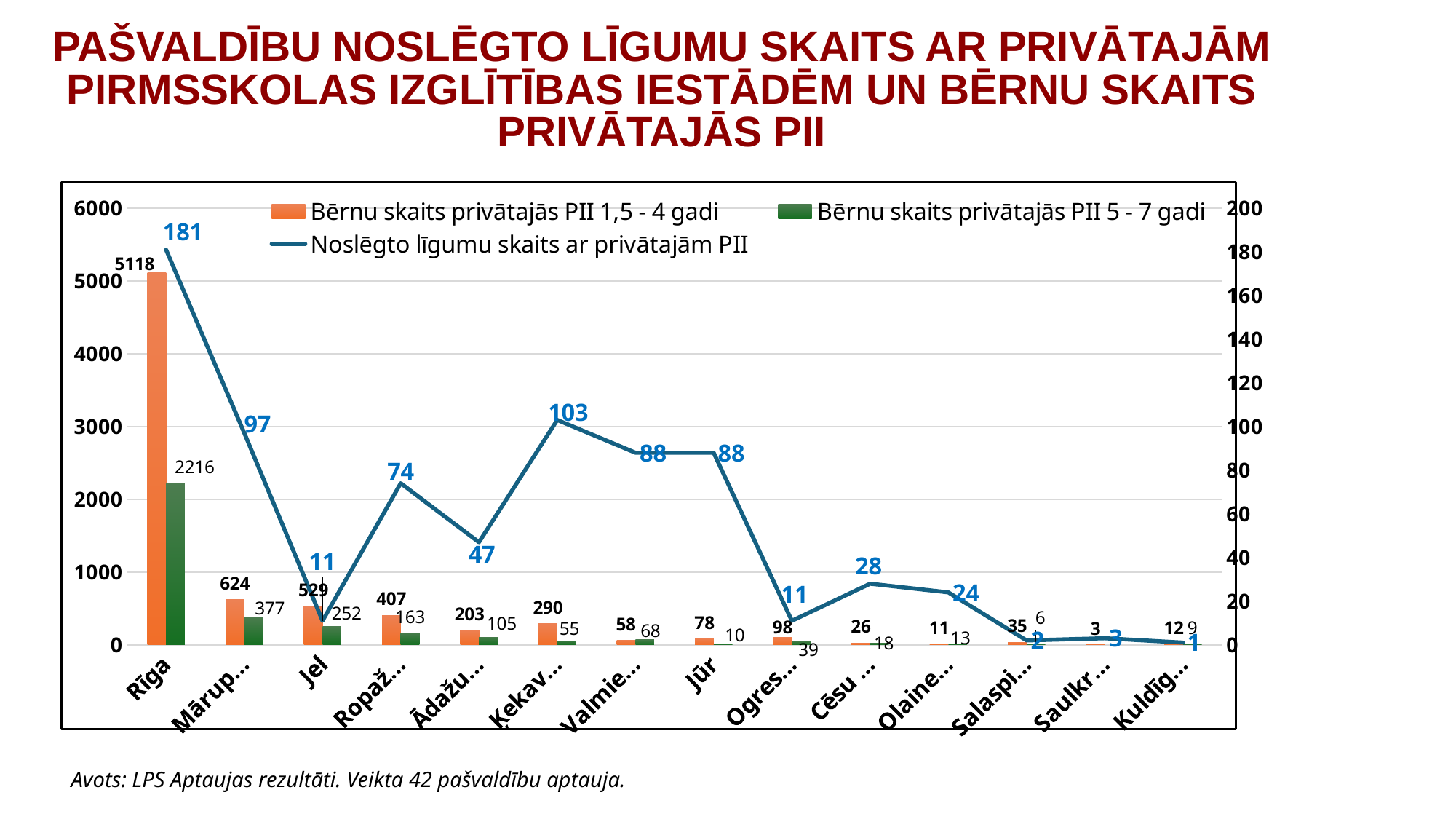
What is the value of 'Bērnu skaits privātajās PII 1,5 - 4 gadi' for Rīga? 5118 What kind of chart is shown on the slide? Combined bar and line chart Which category has the highest value for 'Bērnu skaits privātajās PII 1,5 - 4 gadi'? Rīga How many categories are shown on the x axis? 14 What is the difference between the 'Bērnu skaits privātajās PII 1,5 - 4 gadi' and 'Bērnu skaits privātajās PII 5 - 7 gadi' values for Rīga? 2902 What is the value of 'Noslēgto līgumu skaits ar privātajām PII' for Rīga? 181 What is the value of 'Bērnu skaits privātajās PII 5 - 7 gadi' for Jel? 252 What is the value of 'Bērnu skaits privātajās PII 1,5 - 4 gadi' for Jūr? 78 How many series does the legend list? 3 What is the value of 'Bērnu skaits privātajās PII 5 - 7 gadi' for Rīga? 2216 Which has a larger value for 'Bērnu skaits privātajās PII 1,5 - 4 gadi', Jel or Jūr? Jel What is the value of 'Noslēgto līgumu skaits ar privātajām PII' for Jel? 11